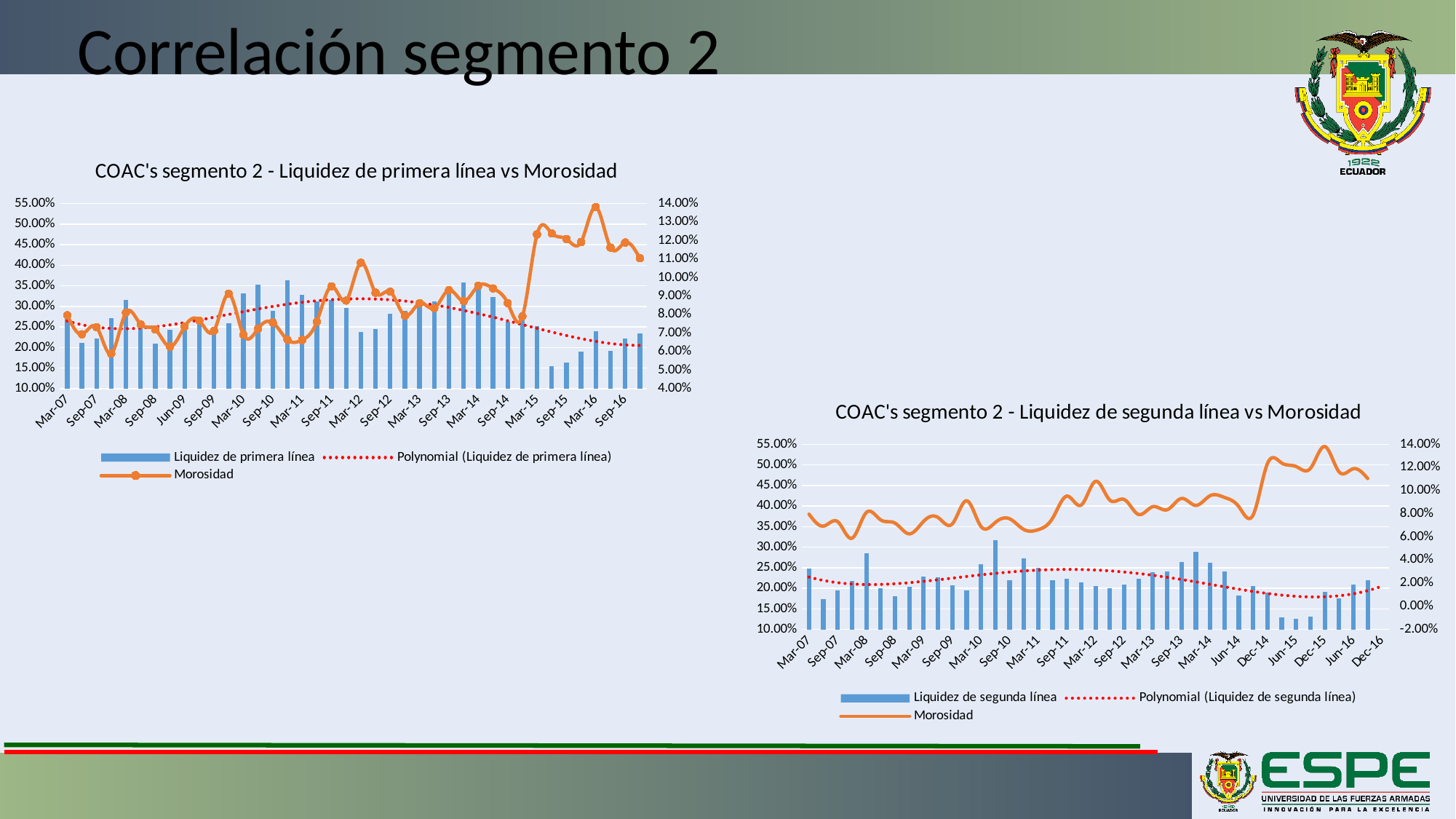
How many series does the legend of the left chart ('Liquidez de primera línea vs Morosidad') list? 3 What type of chart is 'COAC's segmento 2 - Liquidez de primera línea vs Morosidad'? Combined bar and line chart In the right chart ('Liquidez de segunda línea vs Morosidad'), is the Liquidez de segunda línea value at Jun-15 greater or less than 15.00%? less In the left chart ('Liquidez de primera línea vs Morosidad'), at which date does Morosidad reach its highest value? Mar-16 In the left chart ('Liquidez de primera línea vs Morosidad'), does the Morosidad line overall rise or fall from Mar-07 to Sep-16? rise In the left chart ('Liquidez de primera línea vs Morosidad'), is the Liquidez de primera línea value at Mar-11 greater or less than 30.00%? greater In the right chart ('Liquidez de segunda línea vs Morosidad'), is the Morosidad value at Dec-15 greater or less than 12.00%? greater In the right chart ('Liquidez de segunda línea vs Morosidad'), which series is drawn as bars? Liquidez de segunda línea In the right chart ('Liquidez de segunda línea vs Morosidad'), at which date does Morosidad reach its highest value? Dec-15